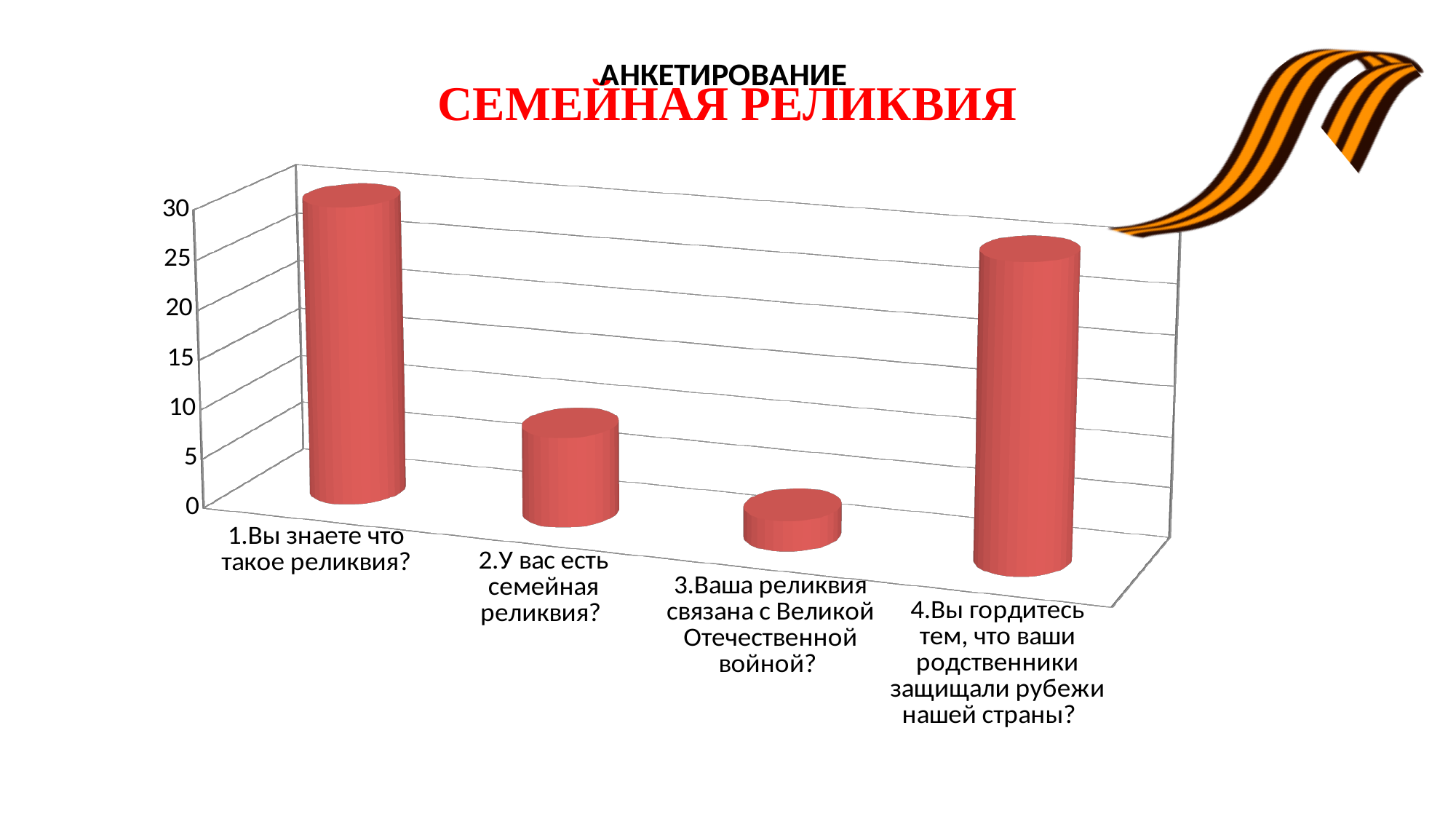
Which category has the lowest bar? 3.Ваша реликвия связана с Великой Отечественной войной? Is the value for "3.Ваша реликвия связана с Великой Отечественной войной?" greater or less than 10? less What kind of chart is shown on the slide? bar chart Is the value for "1.Вы знаете что такое реликвия?" greater or less than 20? greater How many categories (questions) are plotted in the chart? 4 Which is larger: the value for "3.Ваша реликвия связана с Великой Отечественной войной?" or the value for "4.Вы гордитесь тем, что ваши родственники защищали рубежи нашей страны?"? 4.Вы гордитесь тем, что ваши родственники защищали рубежи нашей страны? Is the value for "4.Вы гордитесь тем, что ваши родственники защищали рубежи нашей страны?" greater or less than 15? greater What is the red title text shown above the chart? СЕМЕЙНАЯ РЕЛИКВИЯ Which is larger: the value for "1.Вы знаете что такое реликвия?" or the value for "2.У вас есть семейная реликвия?"? 1.Вы знаете что такое реликвия? What is the highest value shown on the vertical axis of the chart? 30